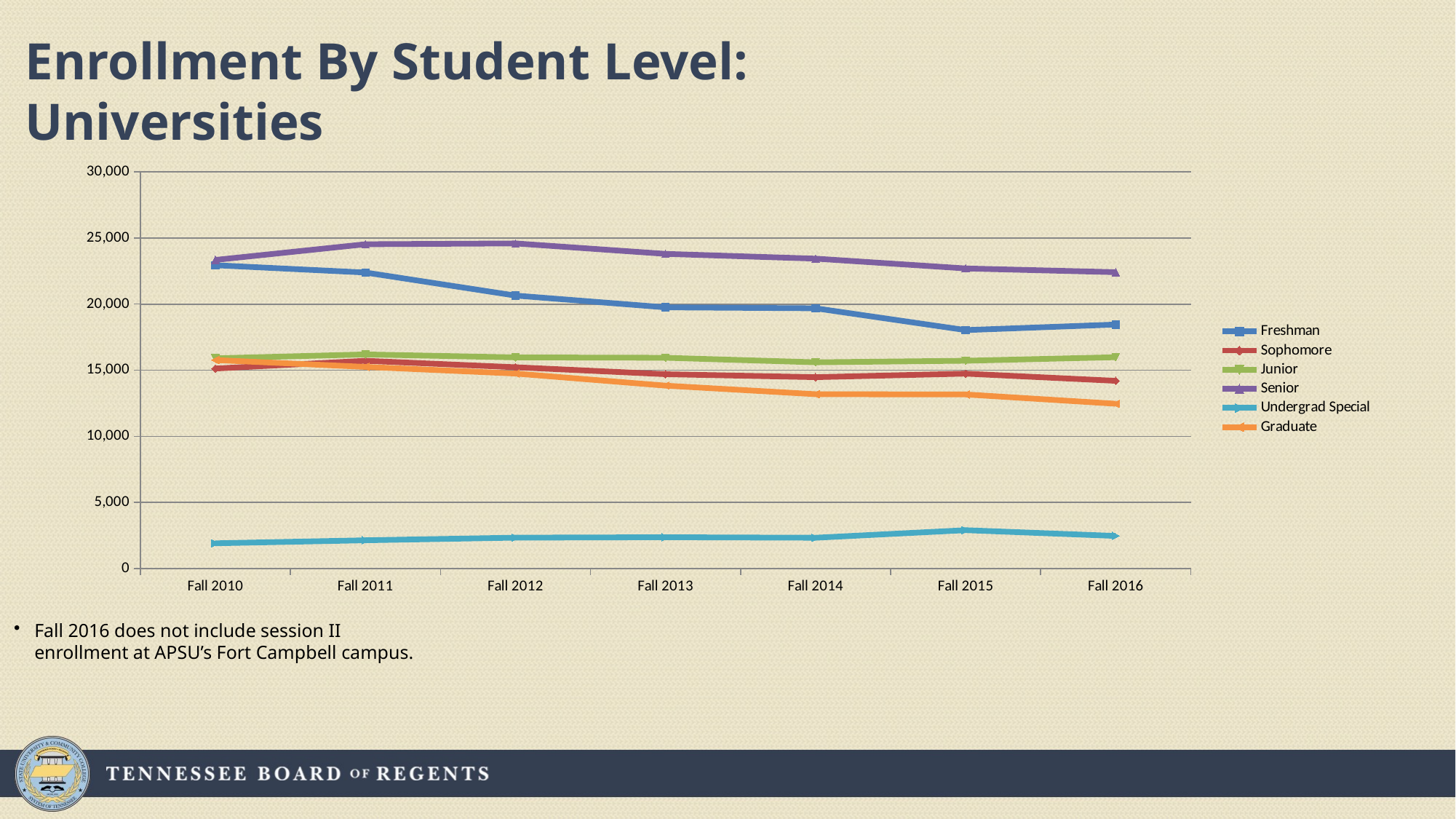
Is the Freshman enrollment in Fall 2015 greater or less than 20,000? less What kind of chart is shown on the slide? Line chart Is the Graduate enrollment in Fall 2016 greater or less than 15,000? less In Fall 2016, which is larger, Freshman enrollment or Sophomore enrollment? Freshman Which student level has the lowest enrollment in Fall 2016? Undergrad Special Is the Undergrad Special enrollment in Fall 2015 greater or less than 5,000? less How many fall terms are plotted along the x axis? 7 How many series does the legend list? 6 Does Freshman enrollment rise or fall from Fall 2010 to Fall 2015? Fall Which student level has the highest enrollment in Fall 2014? Senior Which series is drawn in purple in the legend? Senior